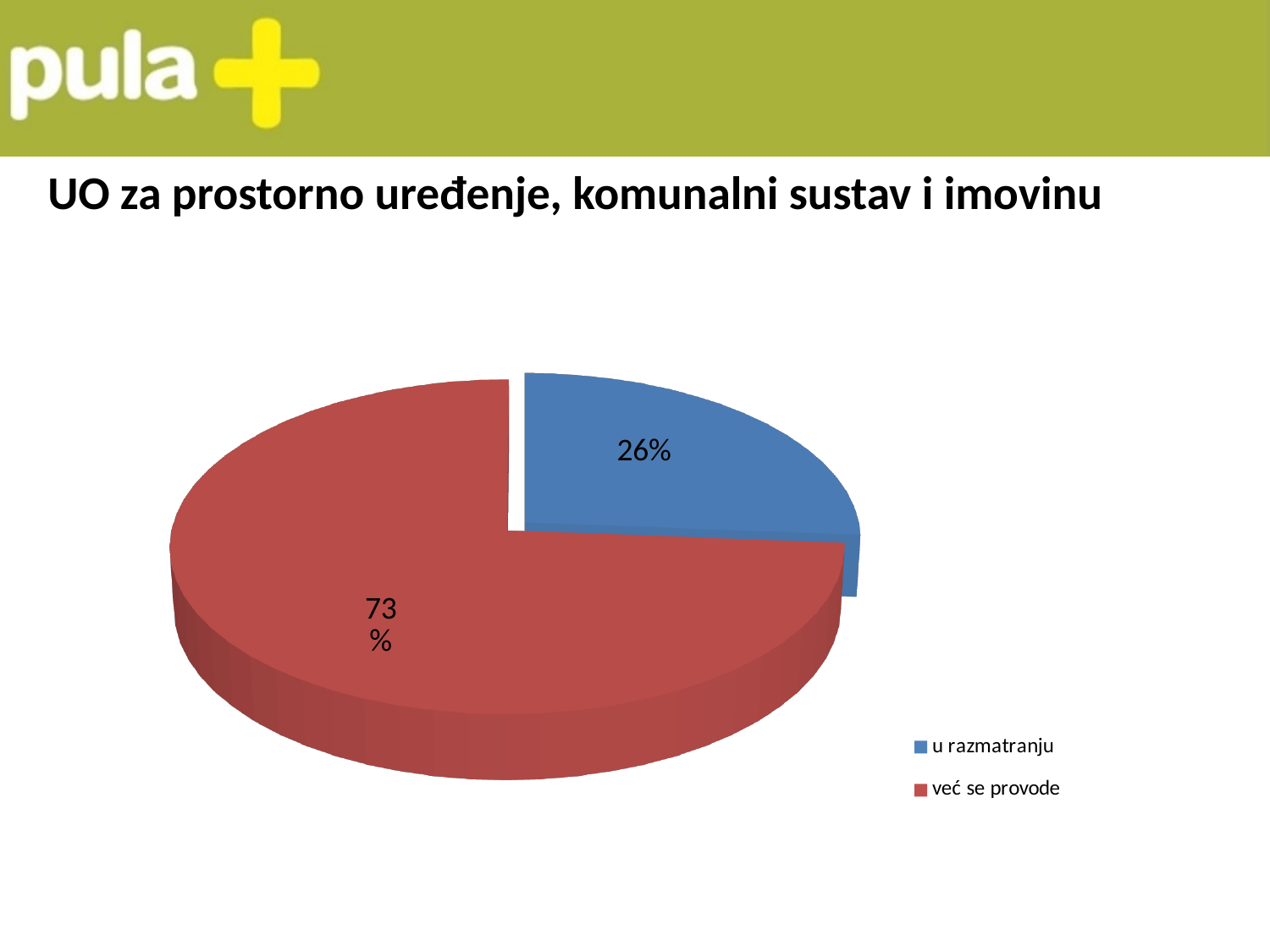
Which slice is the smallest? u razmatranju What colour is the "već se provode" slice? red How many entries does the legend list? 2 What share of the pie does "u razmatranju" represent? 26% What kind of chart is shown on the slide? pie chart What colour is the "u razmatranju" slice? blue How many slices does the pie chart have? 2 What share of the pie does "već se provode" represent? 73% What is the difference in percentage points between the "već se provode" and "u razmatranju" slices? 47 Which is larger, the share for "u razmatranju" or for "već se provode"? već se provode Which slice is the largest? već se provode